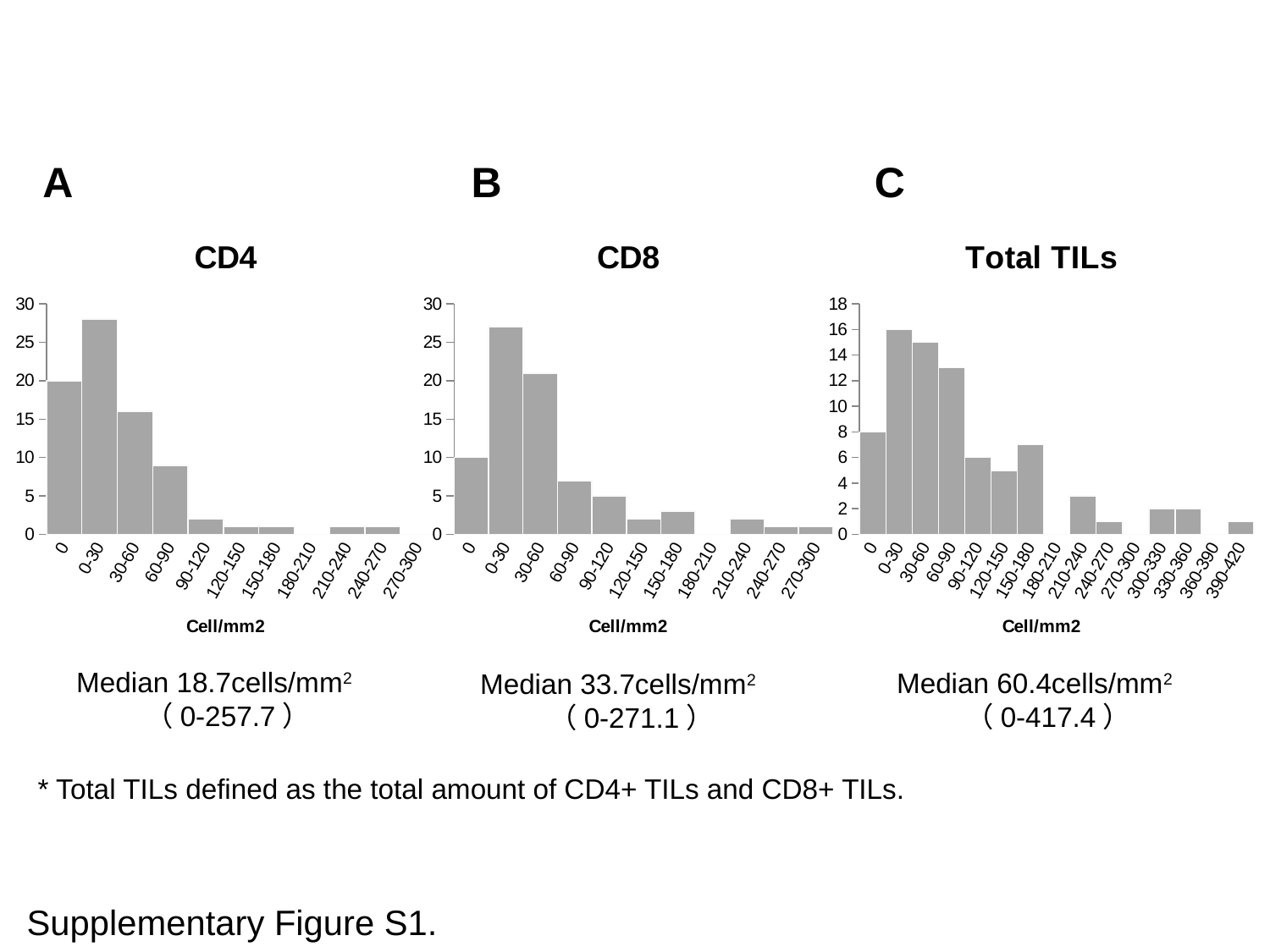
What is the x-axis label on the CD8 chart? Cell/mm2 In the CD4 chart, which category has the tallest bar? 0-30 In the CD8 chart, which is larger, the bar for 0 or the bar for 60-90? 0 In the CD8 chart, is the value for 30-60 greater or less than 20? greater What kind of chart is the CD4 chart (panel A)? bar chart In the Total TILs chart, which is larger, the bar for 60-90 or the bar for 150-180? 60-90 In the CD8 chart, which category has the tallest bar? 0-30 How many categories are shown on the x axis of the CD4 chart? 11 In the CD4 chart, do the bar heights rise or fall from 0-30 to 90-120? fall In the Total TILs chart, is the value for 0-30 greater or less than 14? greater In the CD4 chart, is the value for 0-30 greater or less than 25? greater How many categories are shown on the x axis of the Total TILs chart? 15